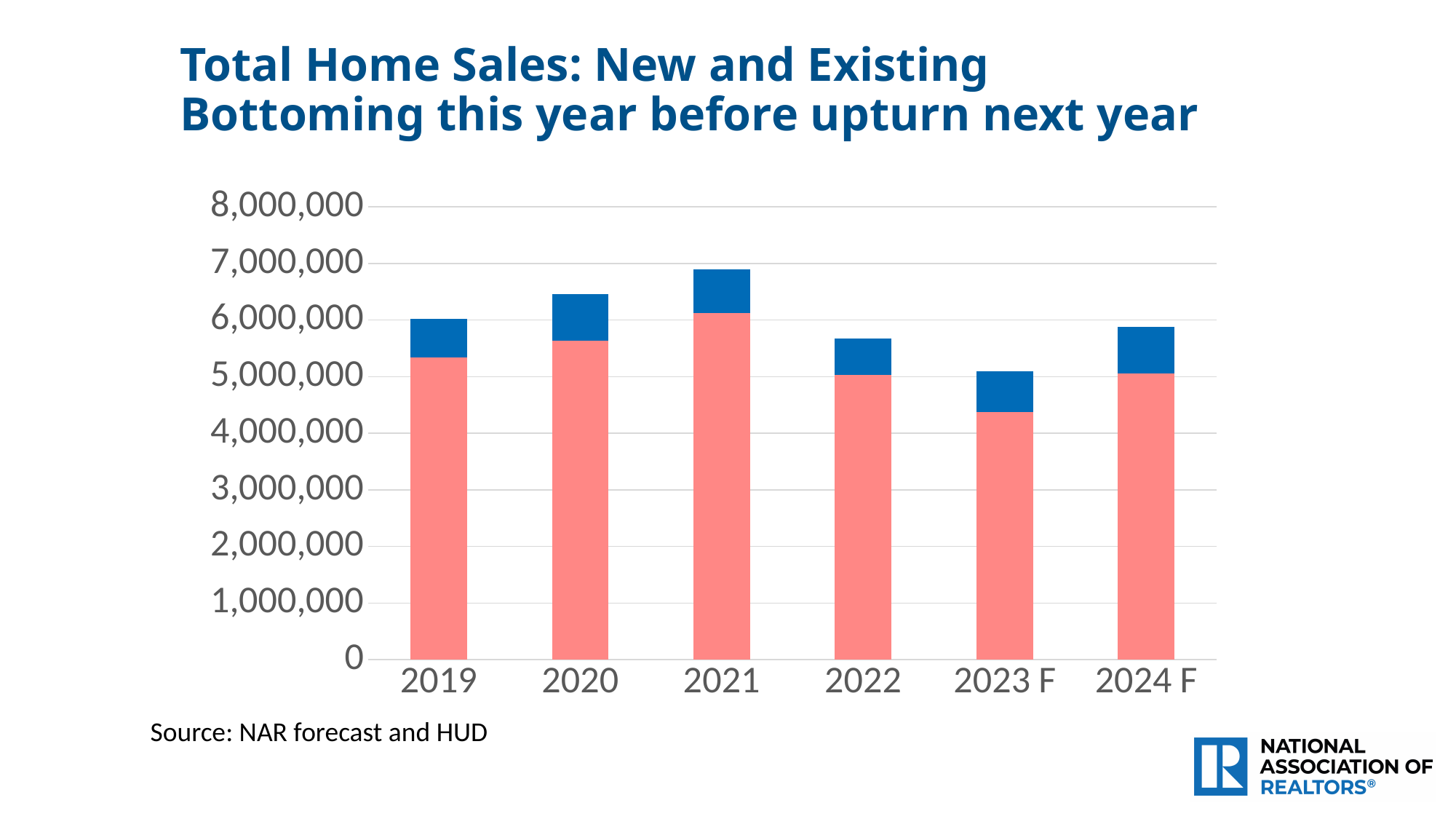
Which year has the highest total bar in the chart? 2021 Is the total value for 2021 greater or less than 6,000,000? greater Is the total value for 2022 greater or less than 5,000,000? greater Is the total value for 2023 F greater or less than 6,000,000? less What kind of chart is shown on the slide? Stacked bar chart How many years are shown on the x axis of the chart? 6 Do the total bars rise or fall from 2021 to 2023 F? fall What source is cited for the chart? NAR forecast and HUD What is the title of the chart on the slide? Total Home Sales: New and Existing Bottoming this year before upturn next year Which year has the lowest total bar in the chart? 2023 F Which has the larger total bar, 2021 or 2022? 2021